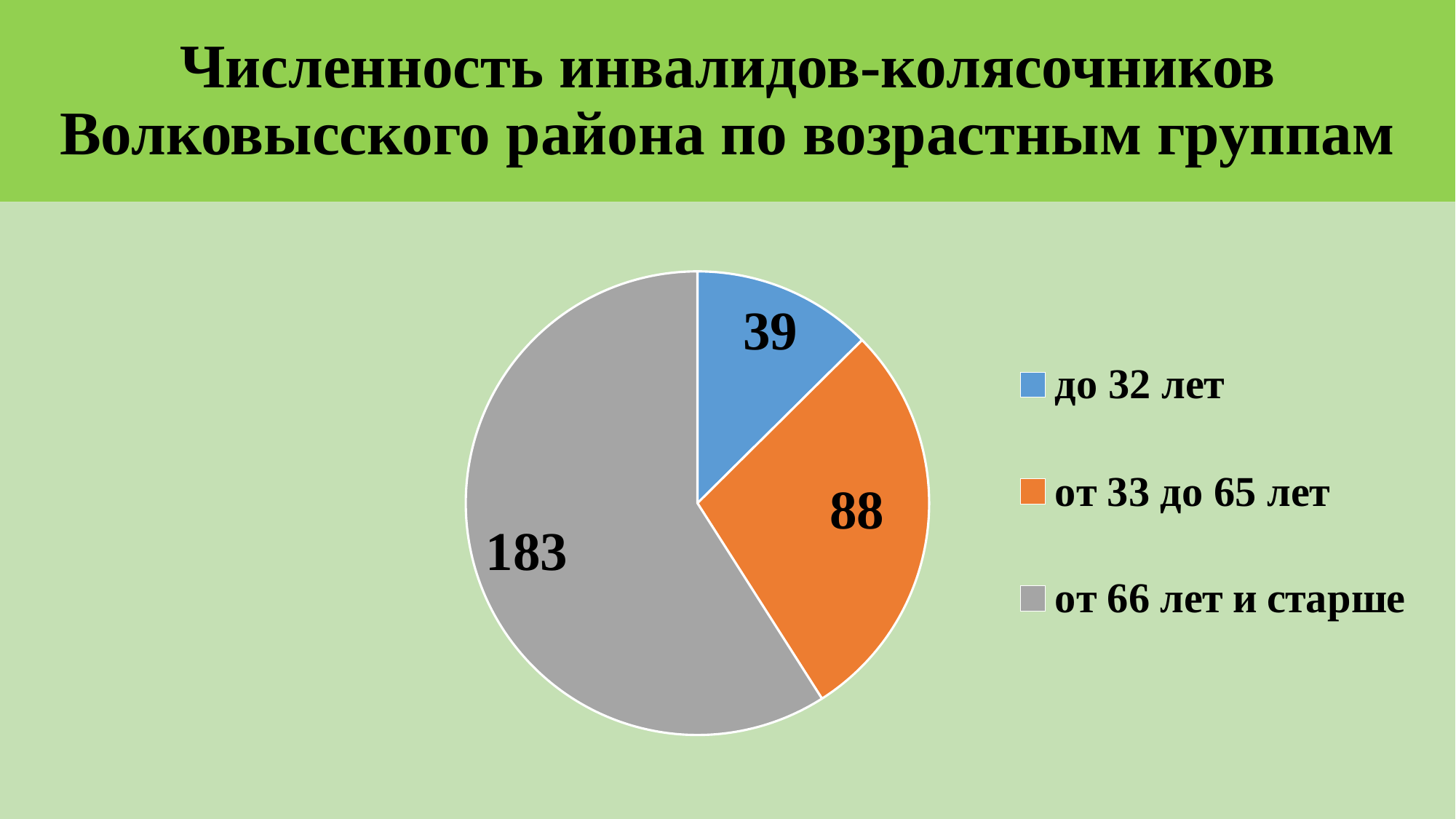
What is the difference between the values for 'от 66 лет и старше' and 'от 33 до 65 лет'? 95 What colour is the slice for 'от 66 лет и старше'? grey What is the value for the 'от 66 лет и старше' slice? 183 Which age group has the largest slice? от 66 лет и старше What is the value for the 'до 32 лет' slice? 39 What is the value for the 'от 33 до 65 лет' slice? 88 What kind of chart is shown on the slide? pie chart What is the difference between the values for 'от 33 до 65 лет' and 'до 32 лет'? 49 How many slices does the pie chart have? 3 What is the total of all slices in the pie chart? 310 Which age group has the smallest slice? до 32 лет Which is larger: the value for 'от 33 до 65 лет' or the value for 'до 32 лет'? от 33 до 65 лет